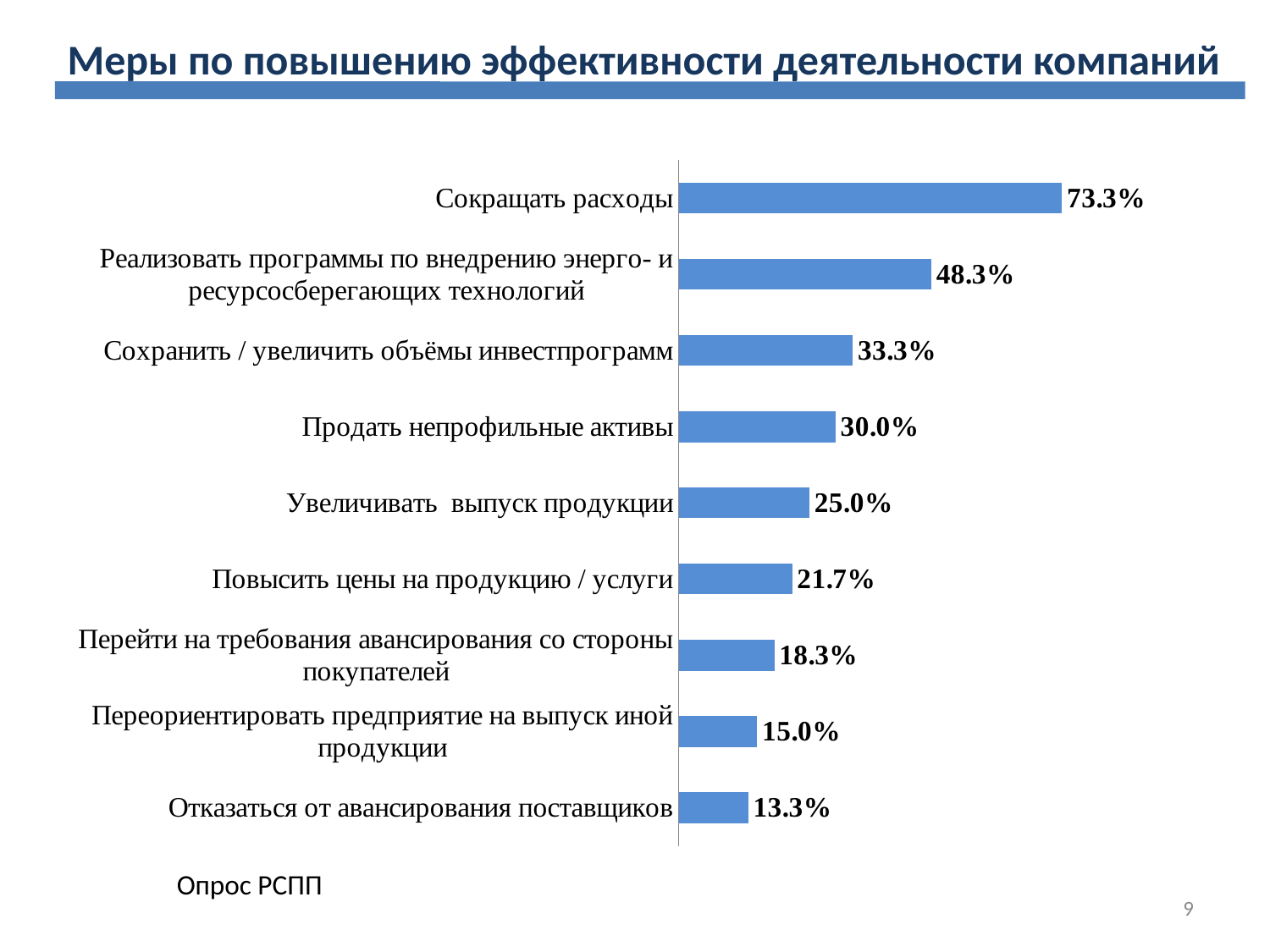
What is the value for "Продать непрофильные активы"? 30.0% What is the difference between the values for "Увеличивать выпуск продукции" and "Переориентировать предприятие на выпуск иной продукции"? 10.0% Which is larger: the value for "Сохранить / увеличить объёмы инвестпрограмм" or the value for "Продать непрофильные активы"? Сохранить / увеличить объёмы инвестпрограмм What is the value for "Повысить цены на продукцию / услуги"? 21.7% Which category has the highest value? Сокращать расходы What kind of chart is shown on the slide? Bar chart How many categories are shown in the chart? 9 What is the value for "Отказаться от авансирования поставщиков"? 13.3% What is the difference between the values for "Сокращать расходы" and "Реализовать программы по внедрению энерго- и ресурсосберегающих технологий"? 25.0% What is the title of the slide? Меры по повышению эффективности деятельности компаний Which category has the lowest value? Отказаться от авансирования поставщиков What is the value for "Сокращать расходы"? 73.3%